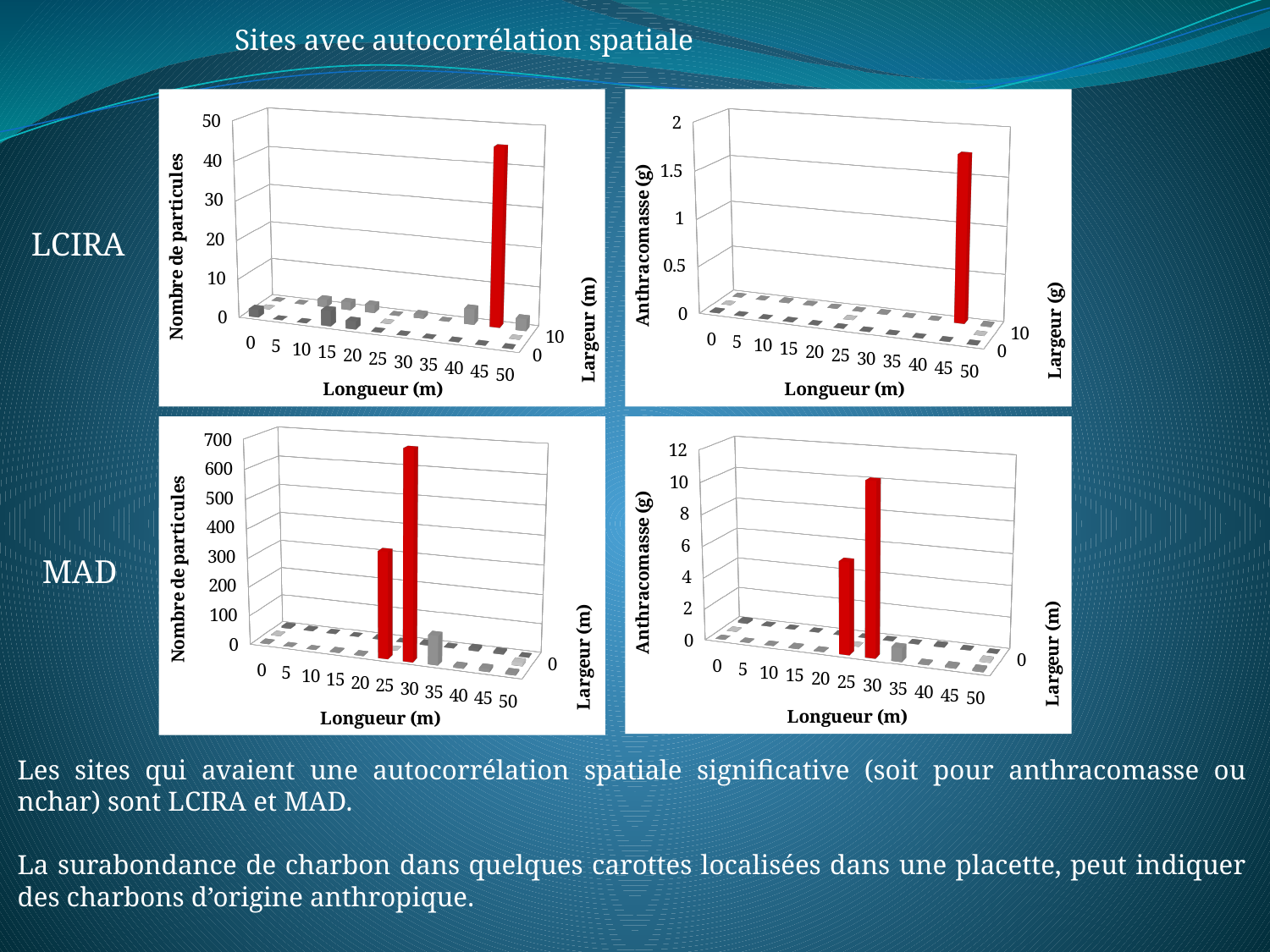
In the MAD Anthracomasse chart (bottom-right), is the tallest bar greater or less than 6? greater In the MAD Nombre de particules chart (bottom-left), at which Longueur (m) value is the tallest bar located? 30 In the LCIRA Nombre de particules chart (top-left), is the tallest bar greater or less than 20? greater What is the title of the horizontal (Longueur) axis on the bottom-left chart for MAD? Longueur (m) In the MAD Nombre de particules chart (bottom-left), is the tallest bar greater or less than 500? greater What is the title of the vertical axis on the top-right chart for LCIRA? Anthracomasse (g) In the LCIRA Nombre de particules chart (top-left), at which Longueur (m) value is the tallest bar located? 45 In the MAD Nombre de particules chart (bottom-left), which bar is taller: the one at Longueur 25 m or the one at Longueur 30 m? 30 m In the MAD Anthracomasse chart (bottom-right), at which Longueur (m) value is the tallest bar located? 30 What kind of chart is the top-left chart for LCIRA (Nombre de particules)? bar chart How many charts are shown on the slide? 4